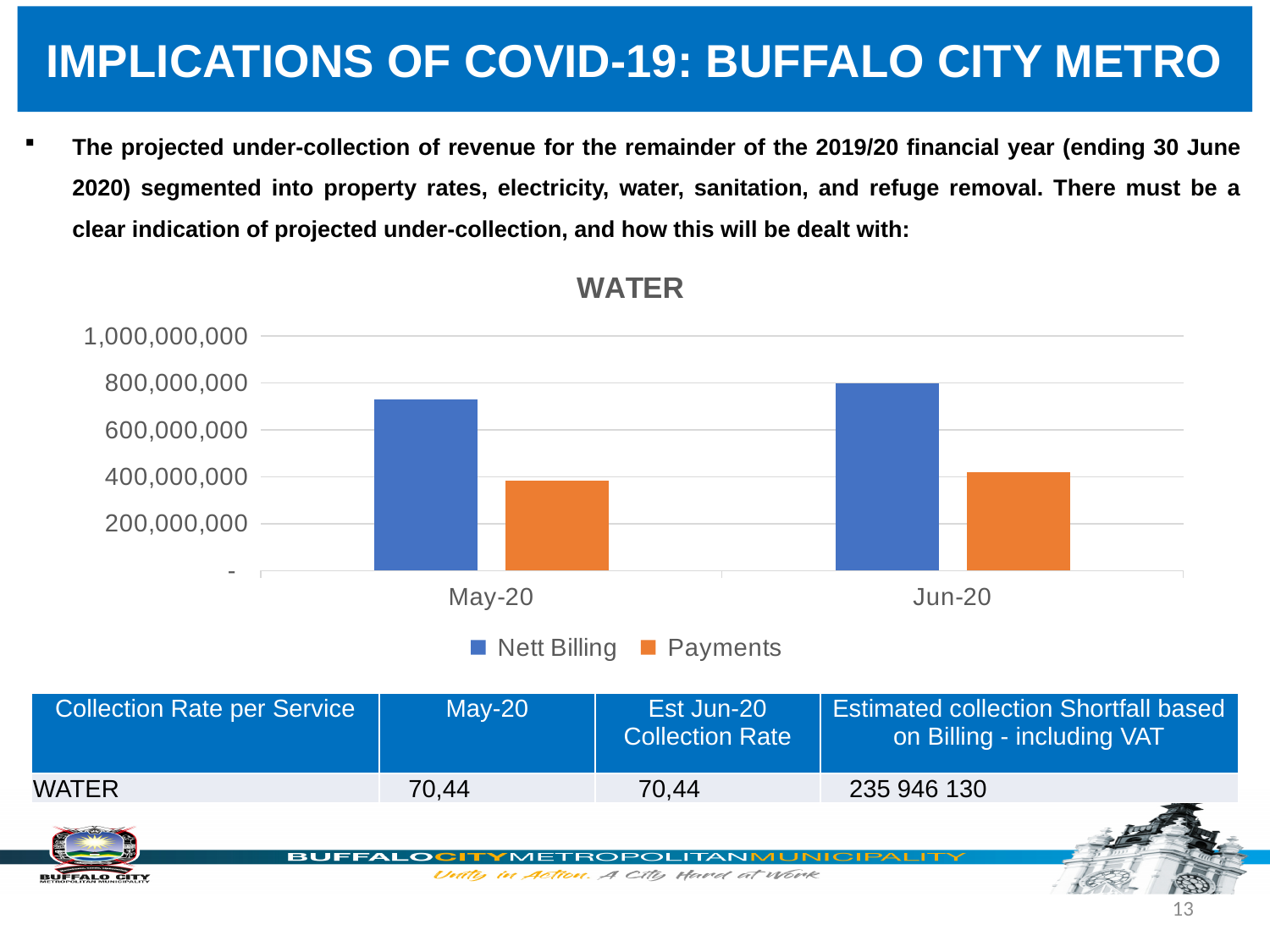
In the WATER chart, which bar is the tallest? Nett Billing for Jun-20 How many categories are shown on the x axis of the WATER chart? 2 Which categories appear on the x axis of the WATER chart? May-20 and Jun-20 In the WATER chart, which is larger for May-20: Nett Billing or Payments? Nett Billing In the WATER chart, is Nett Billing higher in May-20 or in Jun-20? Jun-20 What kind of chart is shown under the title WATER? bar chart In the WATER chart, is the Payments value for May-20 greater or less than 600,000,000? less What are the two series named in the legend of the WATER chart? Nett Billing and Payments In the WATER chart, does Nett Billing rise or fall from May-20 to Jun-20? rise In the WATER chart, is the Nett Billing value for May-20 greater or less than 600,000,000? greater In the WATER chart, is the Payments value for Jun-20 greater or less than 200,000,000? greater How many series does the legend of the WATER chart list? 2